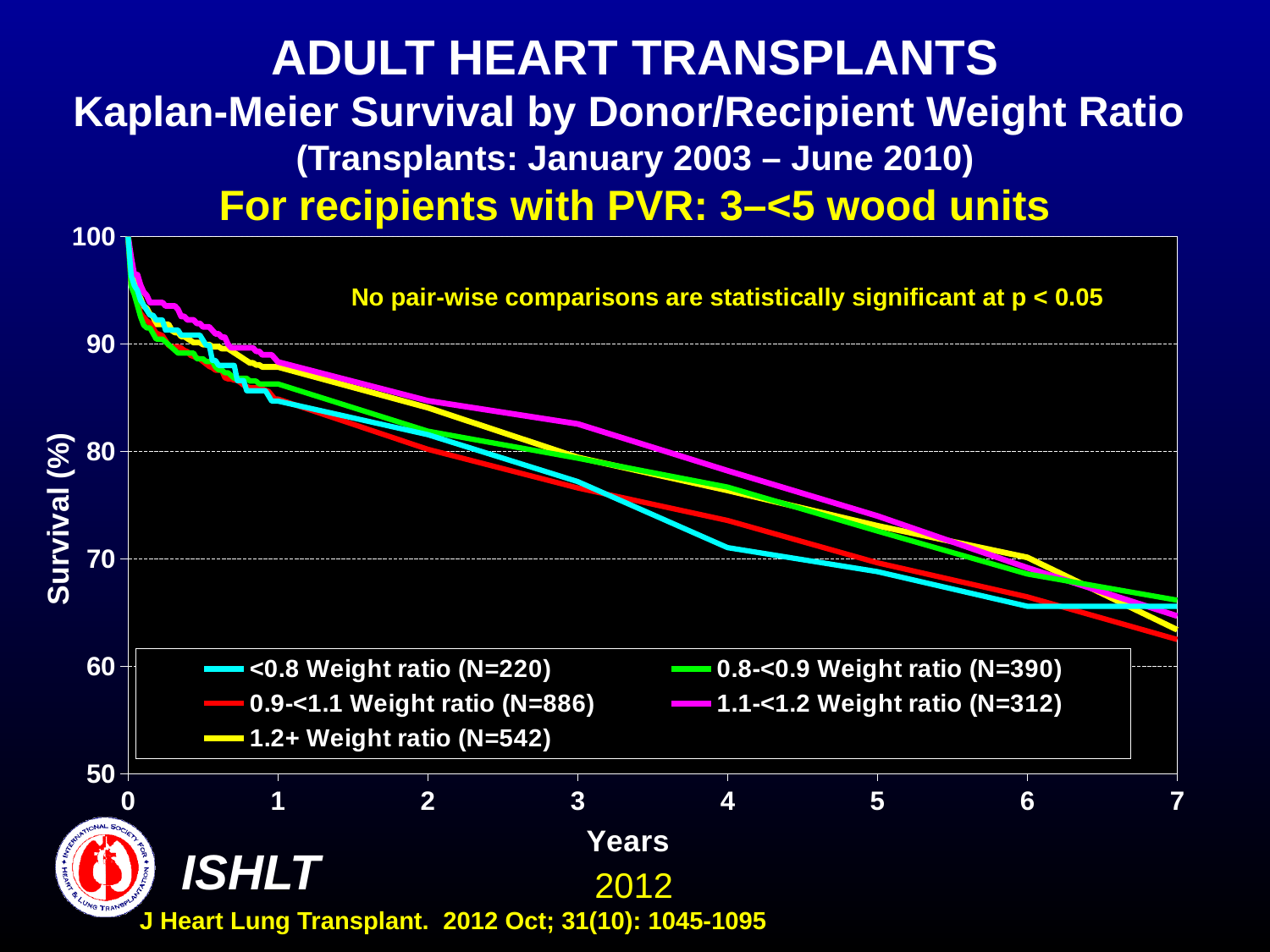
Is the survival value for the <0.8 Weight ratio group at 3 years greater or less than 70? greater Is the survival value for the 0.9-<1.1 Weight ratio group at 7 years greater or less than 70? less At 3 years, which group has higher survival: 1.1-<1.2 Weight ratio or 0.9-<1.1 Weight ratio? 1.1-<1.2 Weight ratio How many series does the legend list? 5 What is the N for the <0.8 Weight ratio group shown in the legend? 220 What is the maximum value shown on the Years axis? 7 What kind of chart is shown on the slide? Line chart Is the survival value for the 1.1-<1.2 Weight ratio group at 3 years greater or less than 80? greater Which weight ratio group has the largest N in the legend? 0.9-<1.1 Weight ratio (N=886) At 4 years, which group has higher survival: 1.1-<1.2 Weight ratio or <0.8 Weight ratio? 1.1-<1.2 Weight ratio Do the survival curves rise or fall as years increase? Fall